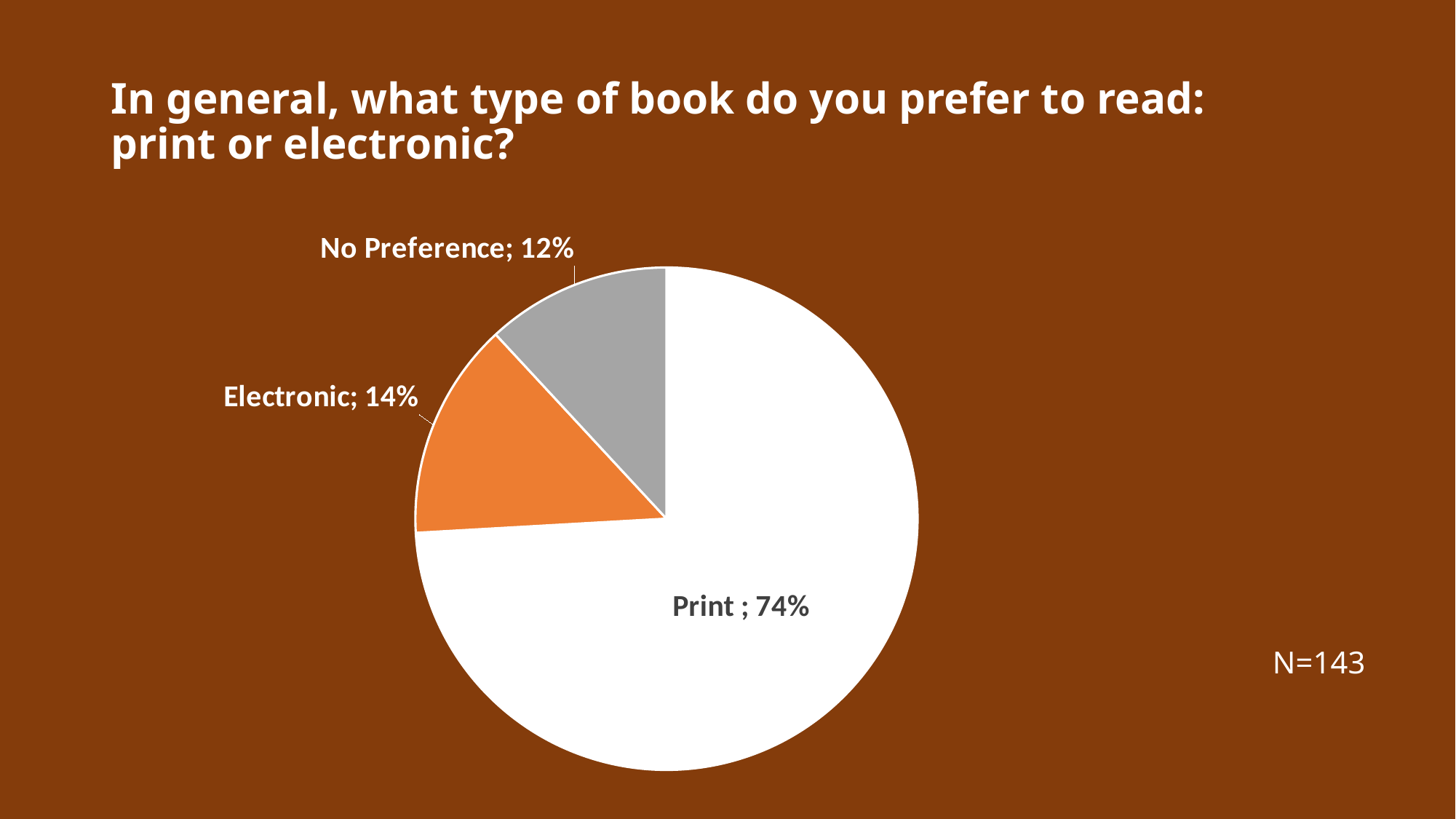
What percentage of respondents prefer electronic books? 14% What is the difference in percentage points between Electronic and No Preference? 2 What percentage of respondents have no preference? 12% Which is larger, the share for Electronic or the share for No Preference? Electronic Which category has the smallest share of the pie? No Preference How many slices does the pie chart have? 3 What is the difference in percentage points between Print and Electronic? 60 What type of chart is shown on the slide? pie chart Which category has the largest share of the pie? Print What is the sample size (N) shown on the slide? N=143 What colour is the Electronic slice? orange What percentage of respondents prefer print books? 74%